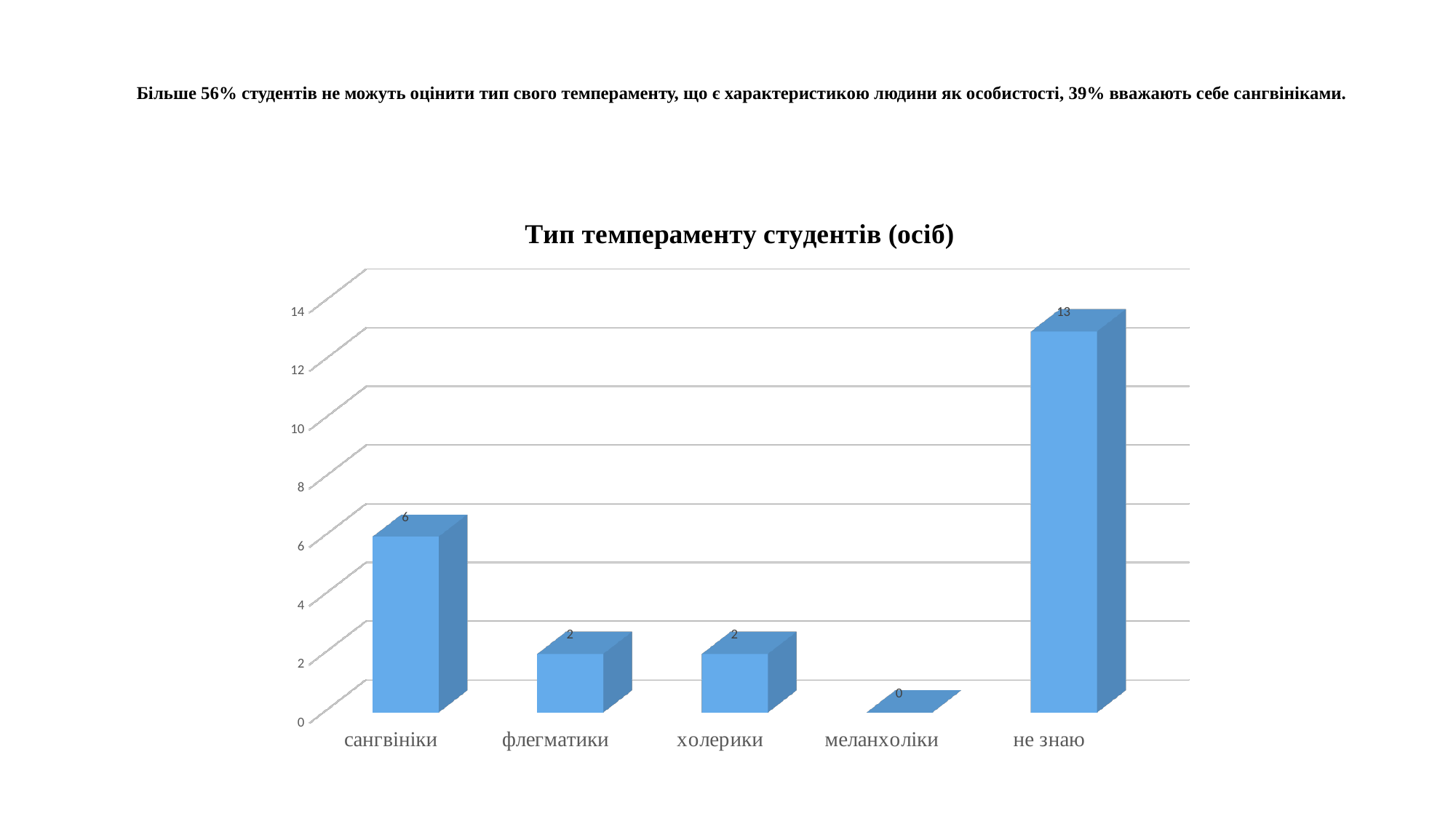
Is the value for не знаю greater or less than 10? greater What is the value for меланхоліки? 0 What kind of chart is shown on the slide? bar chart Which category has the highest value? не знаю Which category has the lowest value? меланхоліки What is the title of the chart? Тип темпераменту студентів (осіб) What is the value for сангвініки? 6 How many categories are shown on the x axis? 5 Which is larger, the value for сангвініки or the value for холерики? сангвініки What is the value for не знаю? 13 What is the difference between the values for не знаю and сангвініки? 7 What is the value for флегматики? 2